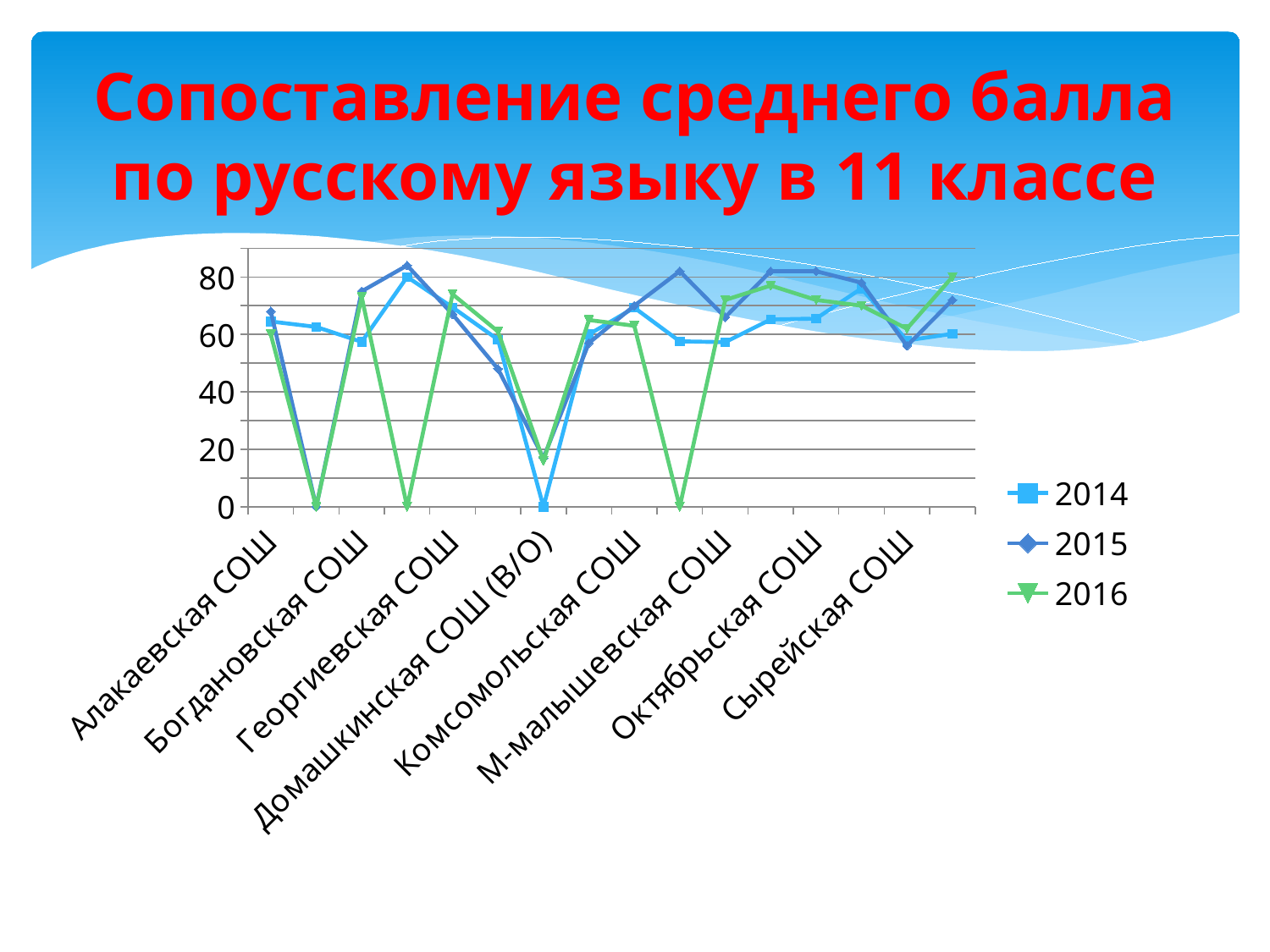
Is the 2014 value for Алакаевская СОШ greater or less than 40? greater Is the 2015 value for Домашкинская СОШ (В/О) greater or less than 40? less For Богдановская СОШ, which is larger: the 2014 value or the 2015 value? 2015 Which years are listed in the chart legend? 2014, 2015, 2016 Is the 2014 value for Домашкинская СОШ (В/О) greater or less than 20? less Which labeled school has the lowest 2014 value? Домашкинская СОШ (В/О) For Октябрьская СОШ, which is larger: the 2014 value or the 2015 value? 2015 What kind of chart is shown on the slide? line chart Which series is drawn in green? 2016 How many series does the legend list? 3